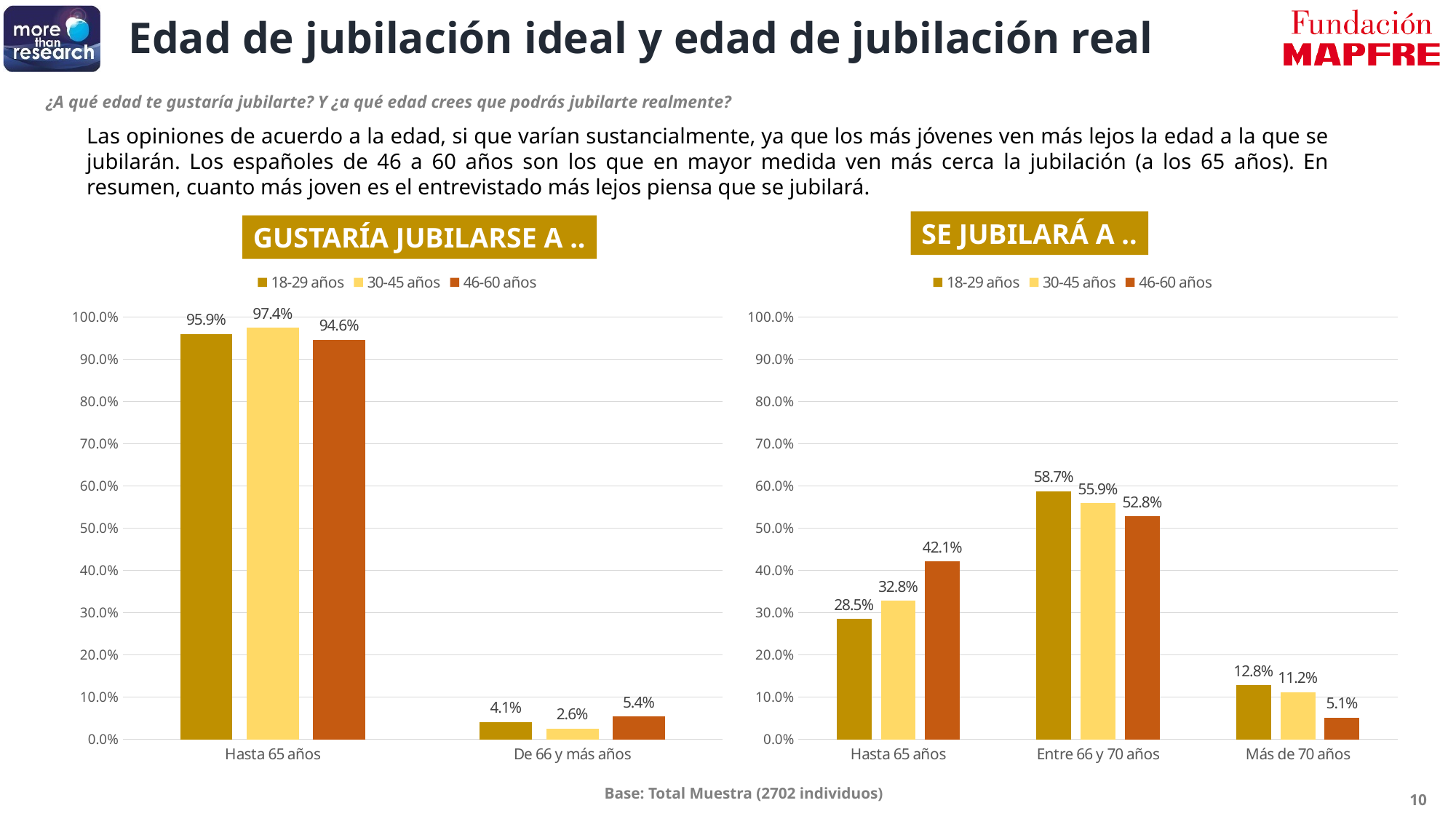
What kind of chart is the 'SE JUBILARÁ A ..' chart? Bar chart How many series does the legend of the 'GUSTARÍA JUBILARSE A ..' chart list? 3 In the 'SE JUBILARÁ A ..' chart, what is the value for 46-60 años in the 'Hasta 65 años' category? 42.1% In the 'SE JUBILARÁ A ..' chart, is the value for 30-45 años in 'Entre 66 y 70 años' greater or less than 50.0%? greater In the 'GUSTARÍA JUBILARSE A ..' chart, which is larger in the 'De 66 y más años' category: 18-29 años or 46-60 años? 46-60 años In the 'SE JUBILARÁ A ..' chart, what is the difference between the 18-29 años and 46-60 años values in the 'Más de 70 años' category? 7.7% In the 'SE JUBILARÁ A ..' chart, what is the value for 18-29 años in the 'Entre 66 y 70 años' category? 58.7% In the 'SE JUBILARÁ A ..' chart, which age group has the lowest value in the 'Hasta 65 años' category? 18-29 años In the 'GUSTARÍA JUBILARSE A ..' chart, what is the value for 18-29 años in the 'Hasta 65 años' category? 95.9% How many categories are shown on the x axis of the 'SE JUBILARÁ A ..' chart? 3 In the 'GUSTARÍA JUBILARSE A ..' chart, what is the value for 30-45 años in the 'De 66 y más años' category? 2.6% In the 'SE JUBILARÁ A ..' chart, which age group has the highest value in the 'Más de 70 años' category? 18-29 años